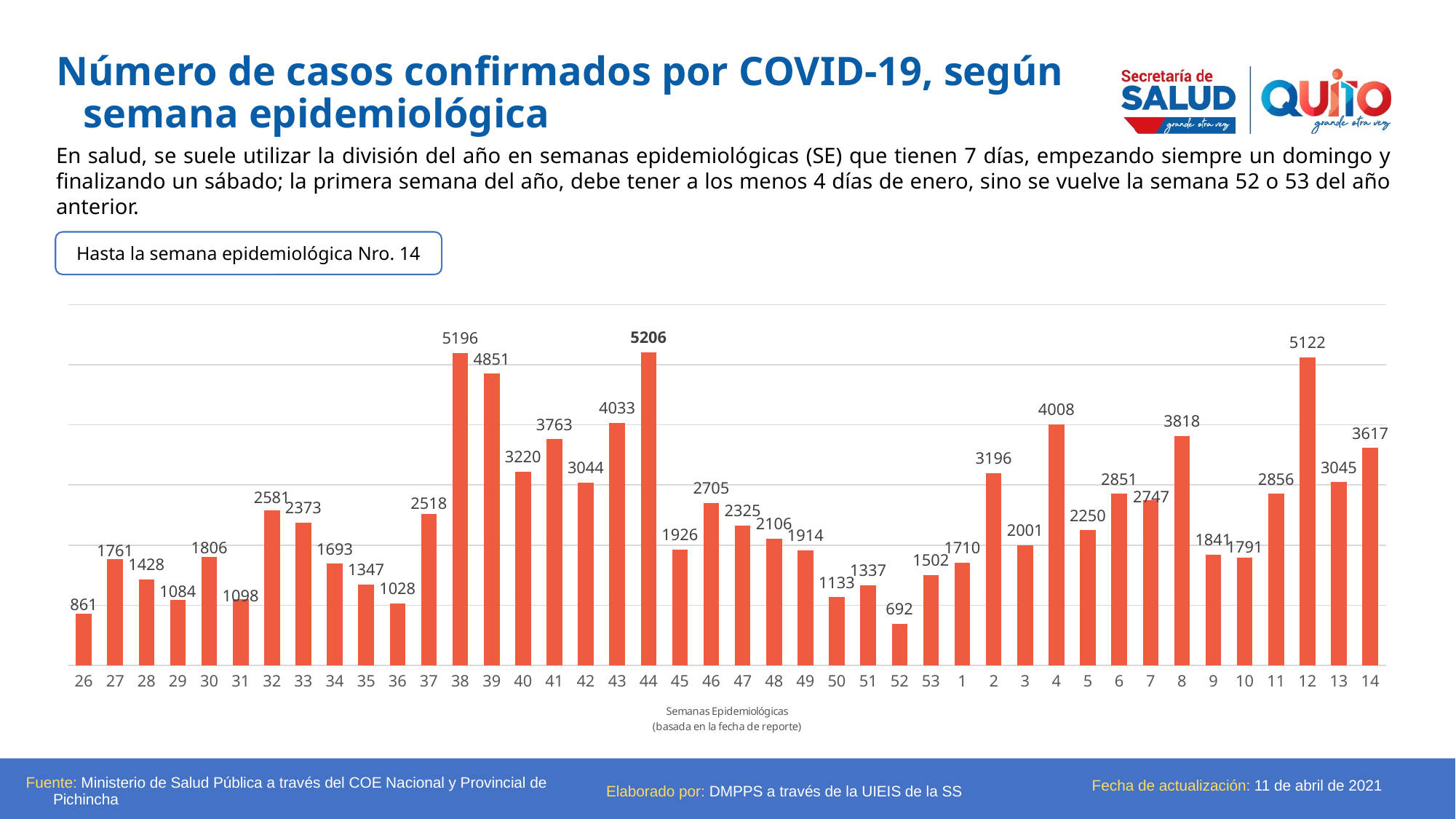
What is the title of the x axis of the chart? Semanas Epidemiológicas (basada en la fecha de reporte) What is the number of confirmed cases for epidemiological week 14? 3617 What is the difference in confirmed cases between week 44 and week 38? 10 What is the number of confirmed cases for epidemiological week 12? 5122 Which epidemiological week has the lowest number of confirmed cases? 52 Do the confirmed cases rise or fall from week 38 to week 40? Fall Which epidemiological week has the highest number of confirmed cases? 44 Which has more confirmed cases, week 39 or week 12? Week 12 What kind of chart is used to show the confirmed cases by epidemiological week? Bar chart What is the difference in confirmed cases between week 14 and week 13? 572 What is the number of confirmed cases for epidemiological week 38? 5196 How many epidemiological weeks are shown on the chart? 42